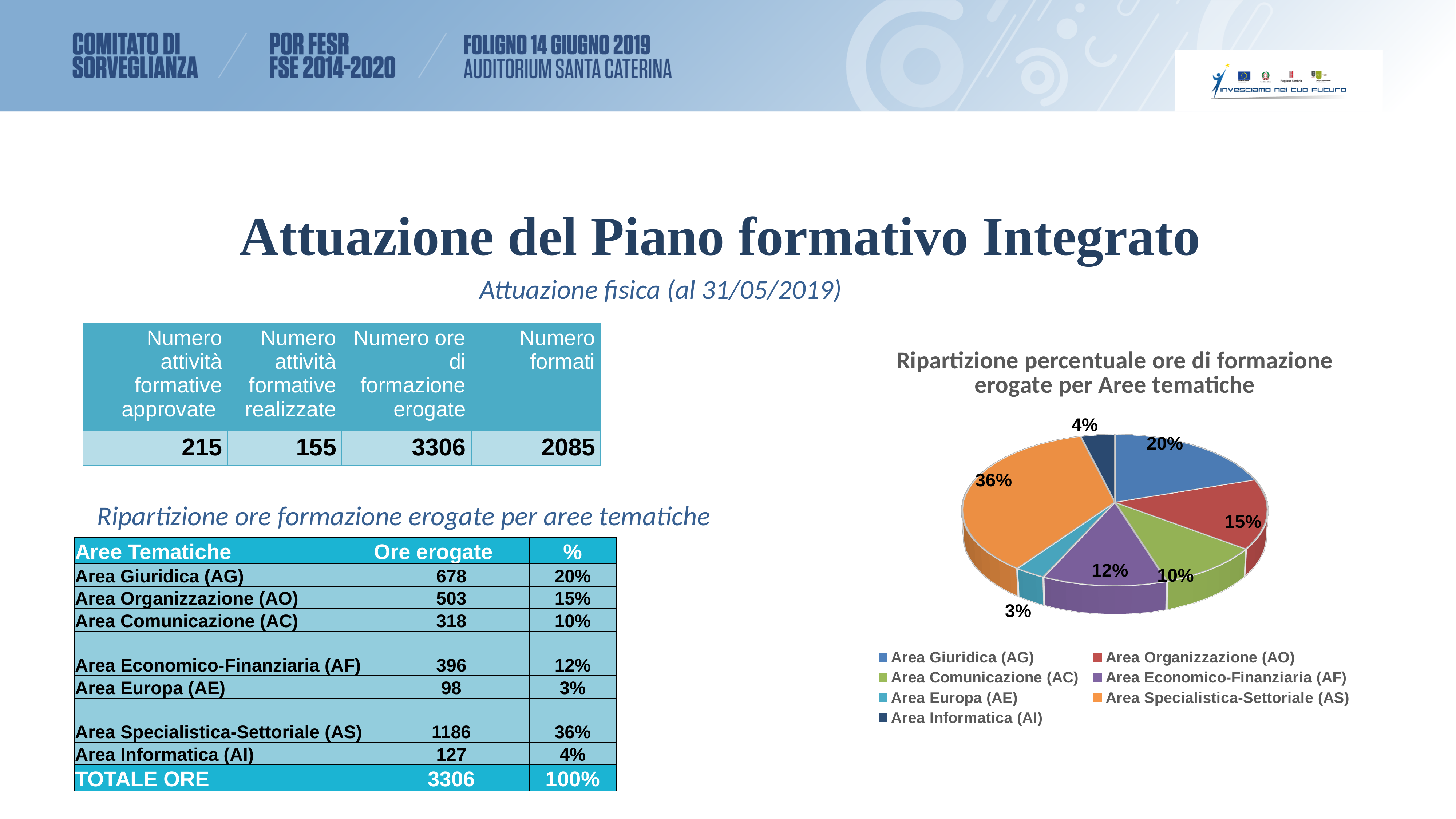
What is the difference in percentage points between the Area Giuridica (AG) slice and the Area Informatica (AI) slice? 16% What share of the pie does Area Giuridica (AG) have? 20% What colour is the Area Specialistica-Settoriale (AS) slice in the pie chart? orange Which area has the smallest slice of the pie chart? Area Europa (AE) What share of the pie does Area Europa (AE) have? 3% What share of the pie does Area Economico-Finanziaria (AF) have? 12% Which area has the largest slice of the pie chart? Area Specialistica-Settoriale (AS) What is the title of the pie chart? Ripartizione percentuale ore di formazione erogate per Aree tematiche Which slice is larger in the pie chart, Area Organizzazione (AO) or Area Comunicazione (AC)? Area Organizzazione (AO) How many slices does the pie chart have? 7 What kind of chart is shown on the slide? pie chart